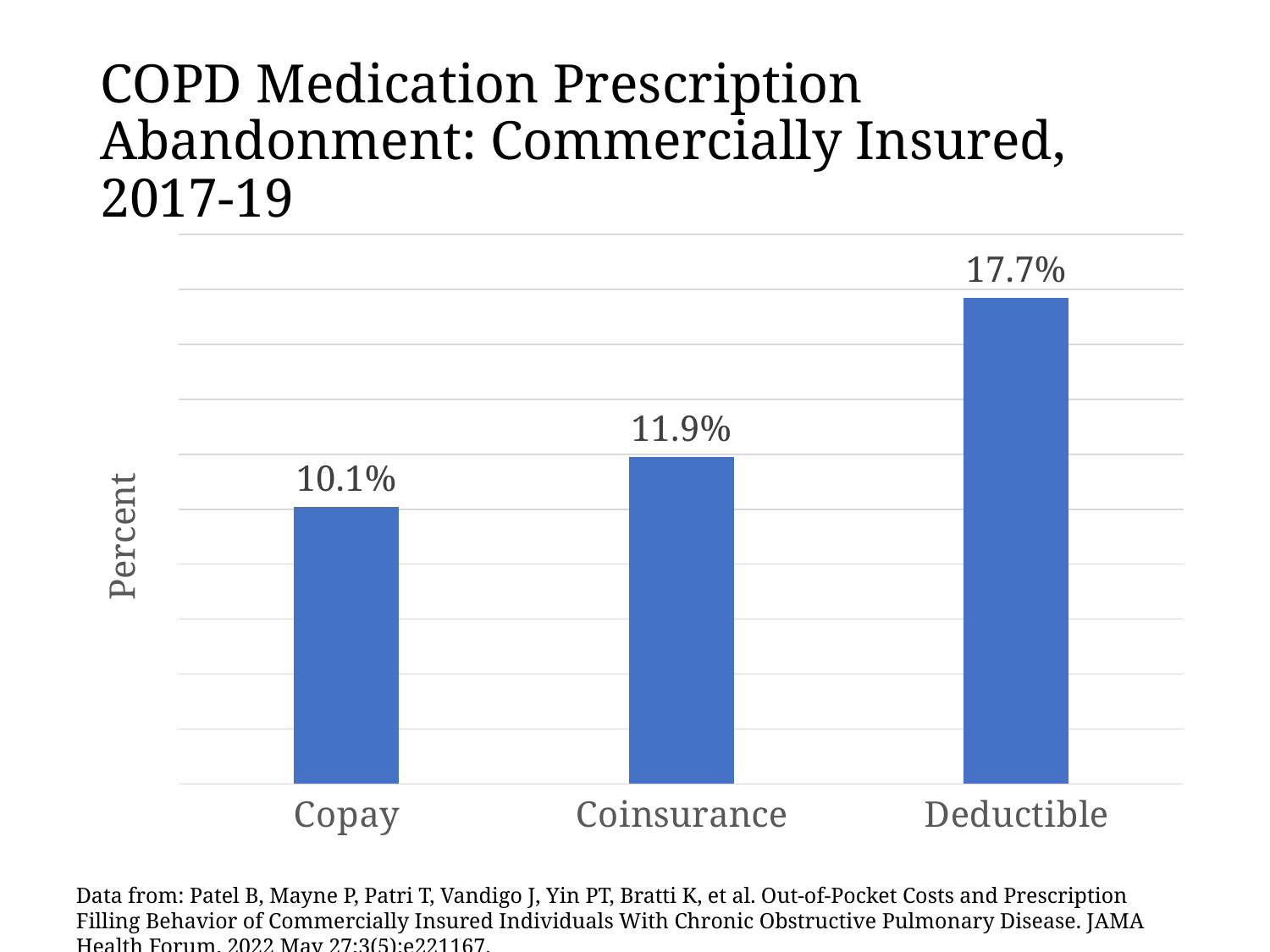
Which category has the lowest abandonment rate? Copay Do the values rise or fall from Copay to Deductible along the x axis? Rise What is the difference between the Coinsurance and Copay abandonment rates? 1.8% What is the abandonment rate for Deductible? 17.7% What is the difference between the Deductible and Copay abandonment rates? 7.6% What kind of chart is shown on the slide? Bar chart Which category has the highest abandonment rate? Deductible What is the abandonment rate for Coinsurance? 11.9% What is the abandonment rate for Copay? 10.1% What is the label on the vertical axis? Percent How many categories are shown on the x axis? 3 Which is larger, the value for Coinsurance or the value for Deductible? Deductible